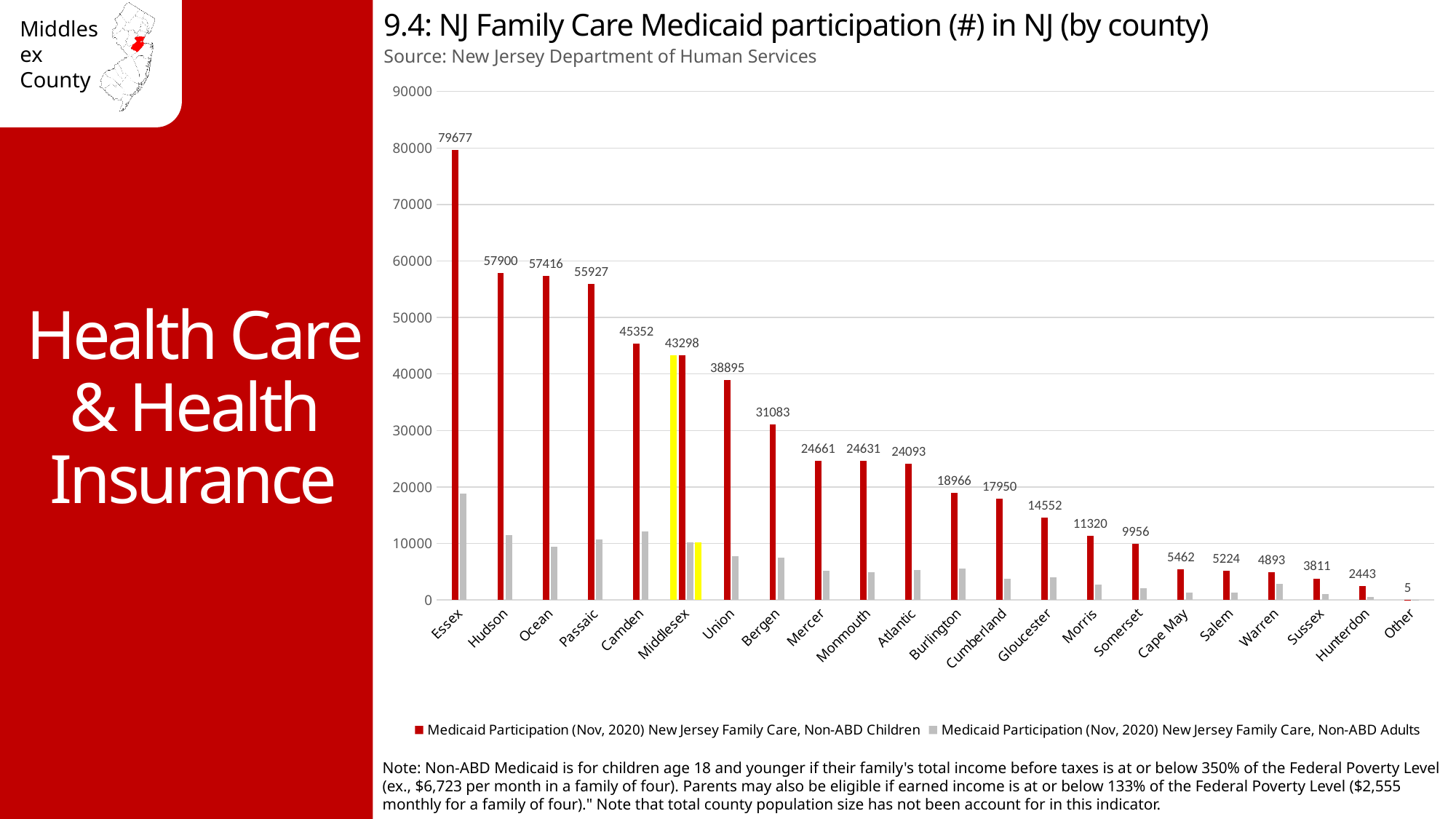
Which county has the highest Non-ABD Children Medicaid participation? Essex How many categories are shown on the x axis? 22 What is the Non-ABD Children Medicaid participation value for Essex? 79677 What is the difference between the Non-ABD Children values for Hudson and Ocean? 484 What is the Non-ABD Children Medicaid participation value for Somerset? 9956 Which category has the lowest Non-ABD Children Medicaid participation? Other What is the Non-ABD Children Medicaid participation value for Middlesex? 43298 Do the Non-ABD Children values rise or fall from left to right along the x axis? Fall What kind of chart is shown on the slide? Bar chart How many series does the legend list? 2 Is the Non-ABD Adults value for Essex greater or less than 10000? greater Which has a larger Non-ABD Children value, Camden or Union? Camden